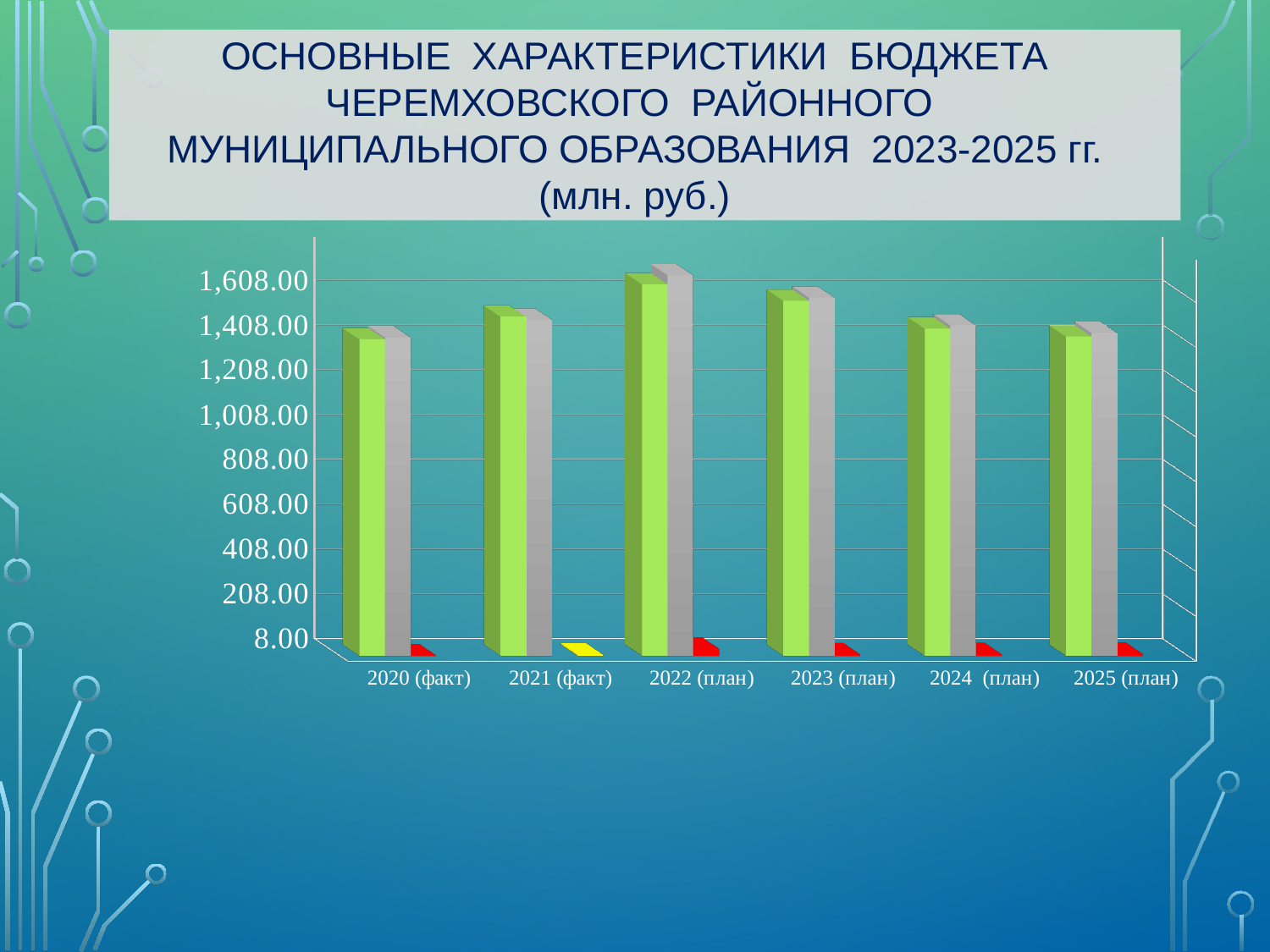
Which year has the tallest green bar? 2022 (план) Which green bar is taller: 2023 (план) or 2025 (план)? 2023 (план) Which green bar is taller: 2022 (план) or 2020 (факт)? 2022 (план) What kind of chart is shown on the slide? Bar chart Is the green bar for 2022 (план) greater or less than 1,408.00? greater What unit of measurement is stated in the chart title? млн. руб. How many year categories are shown along the x axis? 6 What is the highest value labelled on the vertical axis? 1,608.00 Is the green bar for 2023 (план) greater or less than 1,408.00? greater Do the green bars rise or fall from 2022 (план) to 2025 (план)? fall